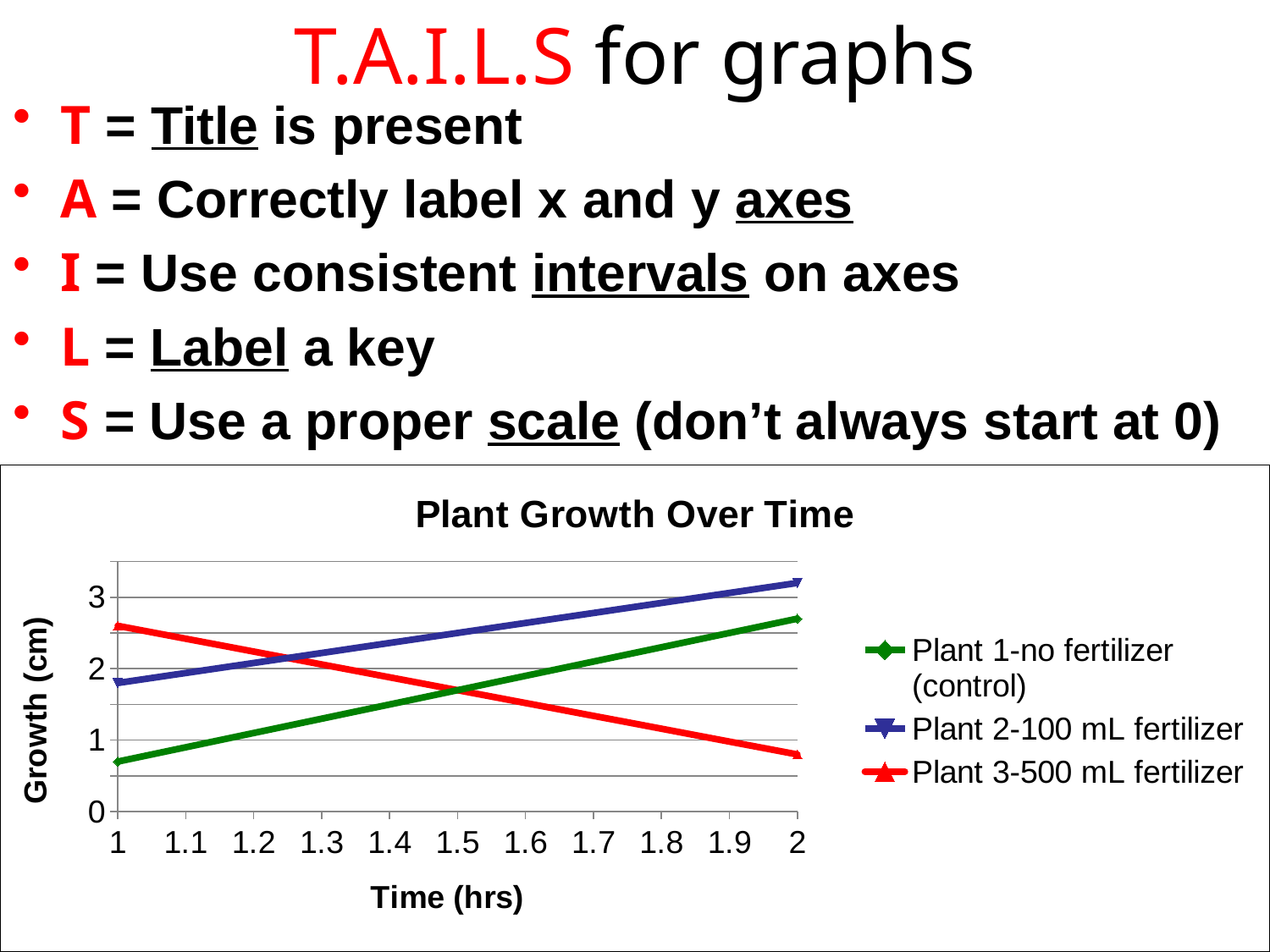
What is the title of the chart? Plant Growth Over Time What kind of chart is shown on the slide? line chart Which series has the highest growth at time 1 hr? Plant 3-500 mL fertilizer Does the line for Plant 3-500 mL fertilizer rise or fall as time increases? fall Does the line for Plant 1-no fertilizer (control) rise or fall as time increases? rise What is the label of the y axis? Growth (cm) Is the growth for Plant 2-100 mL fertilizer at time 2 hrs greater or less than 3? greater Does the line for Plant 2-100 mL fertilizer rise or fall as time increases? rise Is the growth for Plant 3-500 mL fertilizer at time 2 hrs greater or less than 1? less Which series has the lowest growth at time 1 hr? Plant 1-no fertilizer (control) How many series does the chart's legend list? 3 Which series has the highest growth at time 2 hrs? Plant 2-100 mL fertilizer